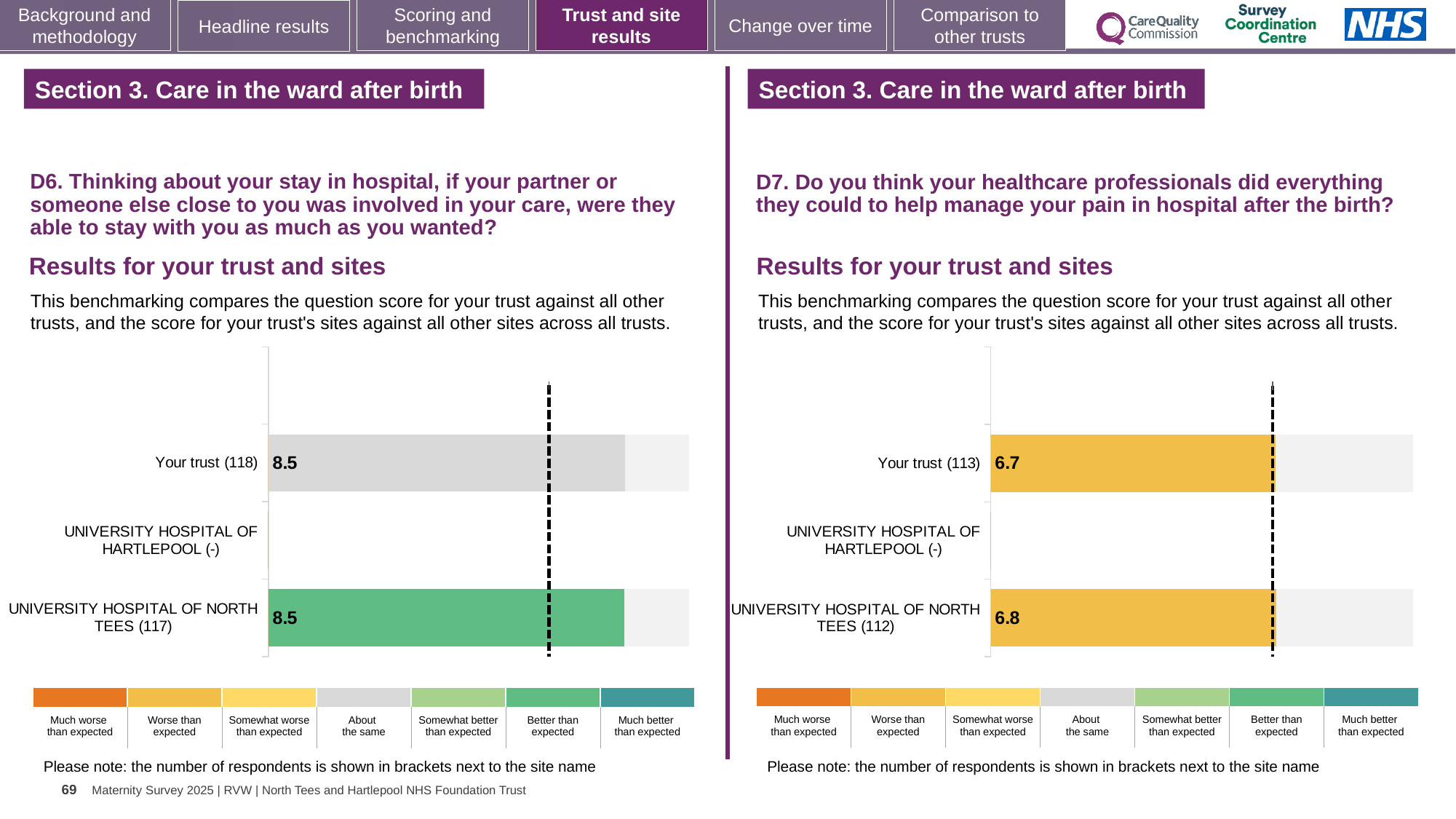
In the D7 chart on the right, what colour are the bars for Your trust and UNIVERSITY HOSPITAL OF NORTH TEES? Yellow/orange In the D7 chart on the right, what is the difference between the score for UNIVERSITY HOSPITAL OF NORTH TEES and the score for Your trust? 0.1 In the D7 chart on the right, what is the score for Your trust (113)? 6.7 In the D6 chart on the left, which category has no bar shown? UNIVERSITY HOSPITAL OF HARTLEPOOL (-) In the D6 chart on the left, is the score for Your trust the same as the score for UNIVERSITY HOSPITAL OF NORTH TEES? Yes In the D7 chart on the right, what is the score for UNIVERSITY HOSPITAL OF NORTH TEES (112)? 6.8 How many respondents are shown in brackets for Your trust in the D7 chart on the right? 113 In the D7 chart on the right, which has the higher score: Your trust or UNIVERSITY HOSPITAL OF NORTH TEES? UNIVERSITY HOSPITAL OF NORTH TEES What type of chart is used for the D7 results on the right? Bar chart In the D6 chart on the left, what is the score for UNIVERSITY HOSPITAL OF NORTH TEES (117)? 8.5 In the D6 chart on the left, what is the score for Your trust (118)? 8.5 How many categories (rows) are listed on the y axis of the D6 chart on the left? 3